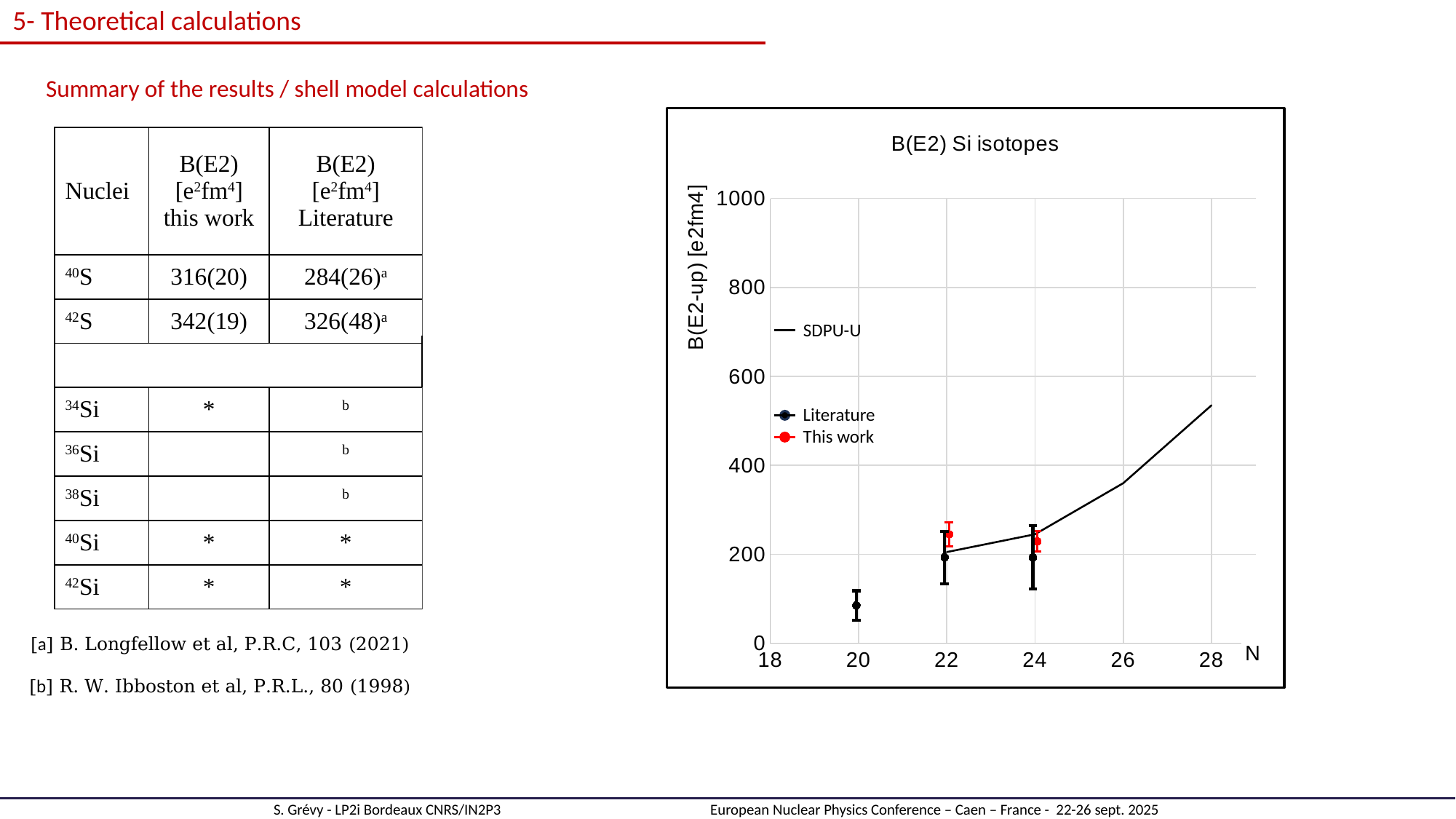
Is the Literature value at N = 20 greater or less than 200? less At which value of N does the SDPU-U line reach its highest point? 28 How many 'This work' data points are plotted in the chart? 2 How many 'Literature' data points are plotted in the chart? 3 Does the SDPU-U line rise or fall as N increases from 22 to 28? rises Is the SDPU-U value at N = 26 greater or less than 400? less How many series does the chart legend list? 3 Is the SDPU-U value at N = 28 greater or less than 400? greater What colour are the 'This work' data points in the chart? red What kind of chart is shown on the slide? line chart At N = 22, which is larger: the 'This work' value or the 'Literature' value? This work What is the title of the chart? B(E2) Si isotopes